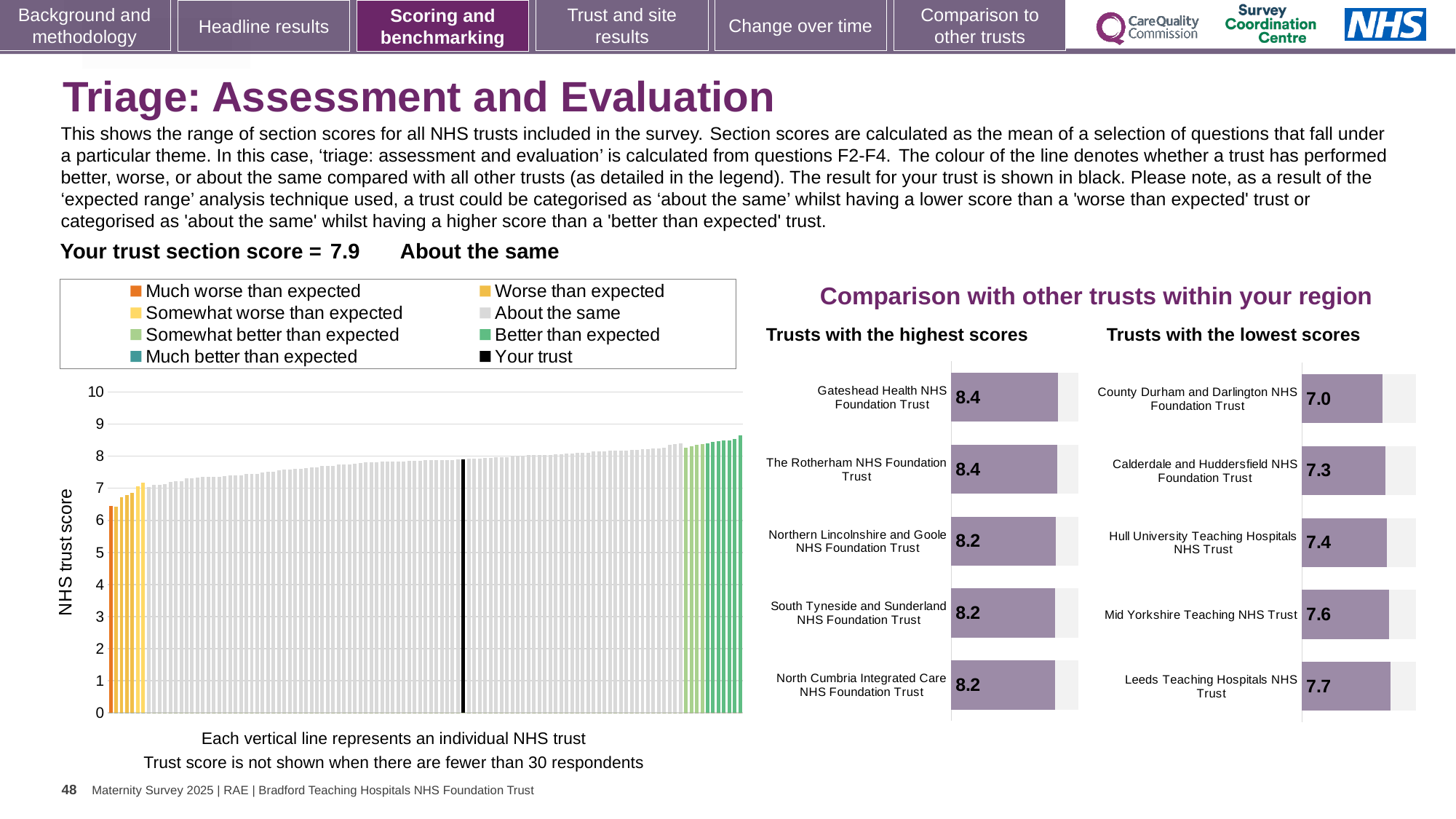
How many trusts are shown in the 'Trusts with the highest scores' chart? 5 In the 'Trusts with the lowest scores' chart, which has the higher score: Hull University Teaching Hospitals NHS Trust or Mid Yorkshire Teaching NHS Trust? Mid Yorkshire Teaching NHS Trust In the 'Trusts with the highest scores' chart, what is the difference between the scores of Gateshead Health NHS Foundation Trust and North Cumbria Integrated Care NHS Foundation Trust? 0.2 In the 'Trusts with the lowest scores' chart, what is the difference between the scores of Leeds Teaching Hospitals NHS Trust and County Durham and Darlington NHS Foundation Trust? 0.7 What kind of chart is the large chart on the left showing NHS trust scores? Bar chart In the 'Trusts with the lowest scores' chart, which trust has the lowest score? County Durham and Darlington NHS Foundation Trust In the 'Trusts with the lowest scores' chart, what is the score for County Durham and Darlington NHS Foundation Trust? 7.0 In the 'Trusts with the lowest scores' chart, what is the score for Calderdale and Huddersfield NHS Foundation Trust? 7.3 How many entries does the legend of the left-hand chart list? 8 In the left-hand chart, do the bar values rise or fall from left to right? Rise In the left-hand chart, is the value of the tallest bar greater or less than 9? less In the 'Trusts with the highest scores' chart, what is the score for Gateshead Health NHS Foundation Trust? 8.4